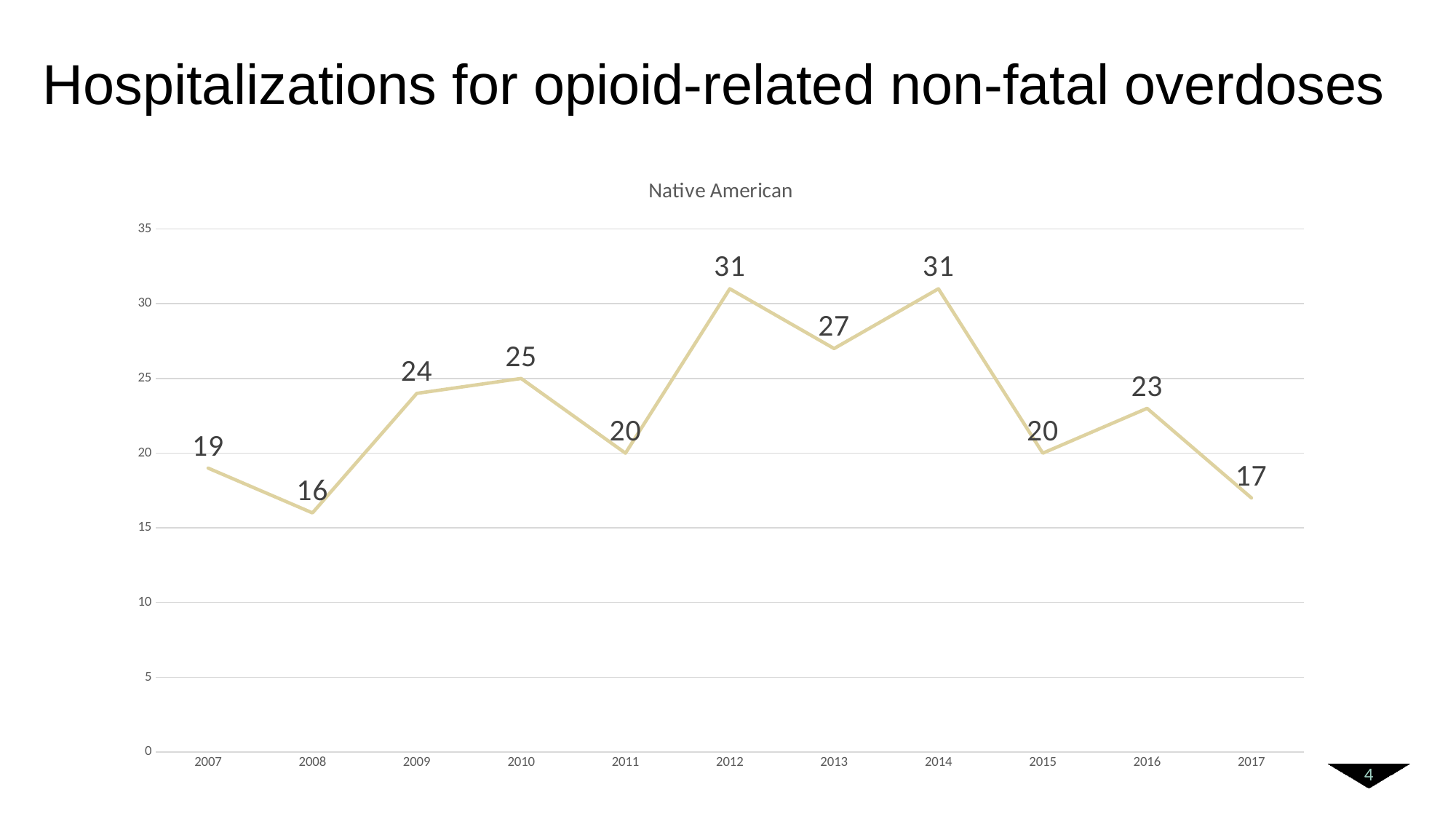
What is the value for 2017? 17 What is the title of the chart? Native American What is the highest value shown on the chart? 31 Is the value for 2013 greater or less than 25? greater What is the difference between the values for 2014 and 2015? 11 What is the value for 2012? 31 Which year has the lowest value? 2008 What kind of chart is shown? line chart Do the values rise or fall from 2014 to 2015? fall Which is larger, the value for 2009 or the value for 2016? 2009 What is the value for 2008? 16 How many years are plotted on the x axis? 11